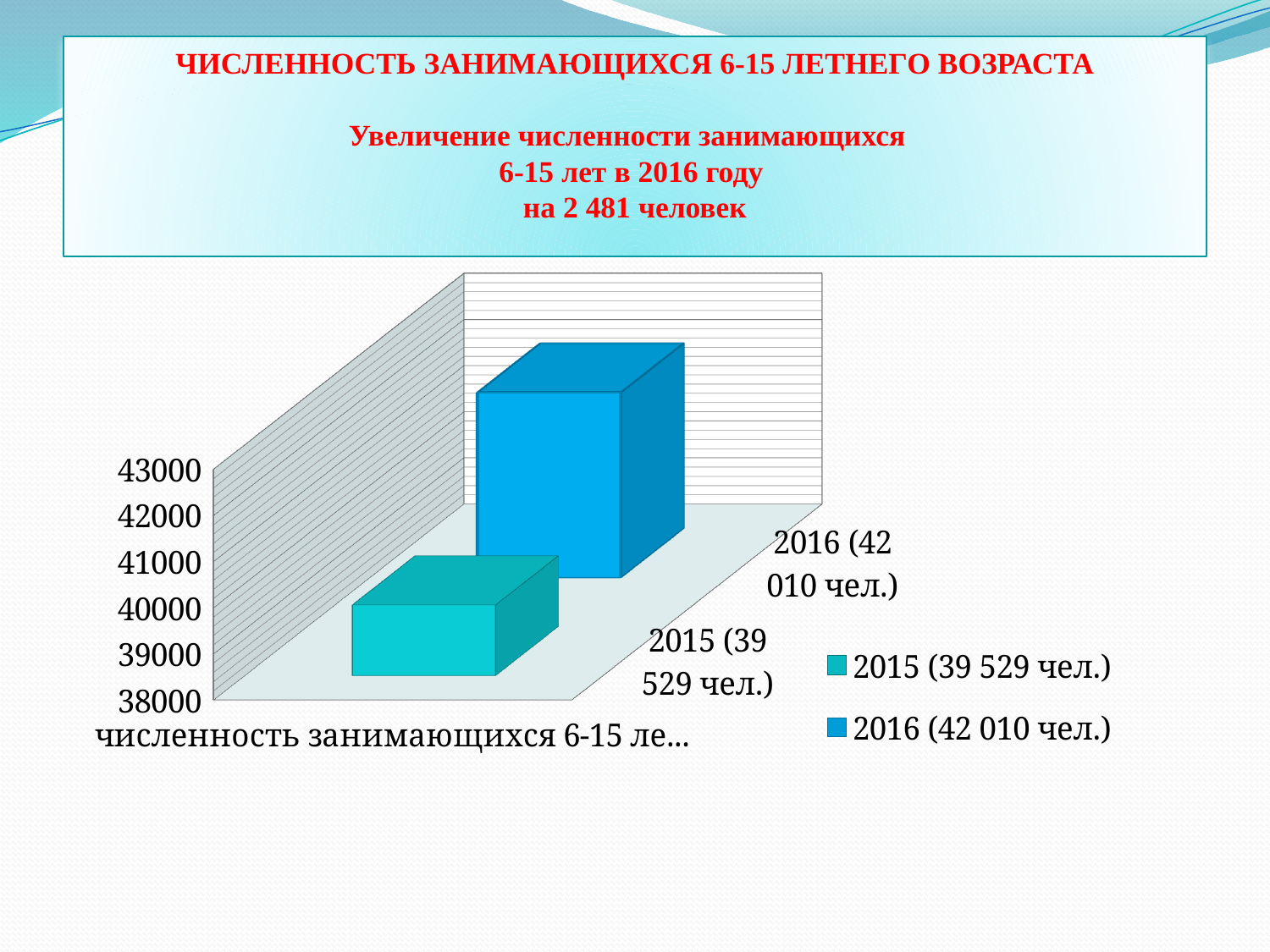
Which series has the lowest value? 2015 (39 529 чел.) Which series has the higher value, 2015 or 2016? 2016 Which series has the highest value? 2016 (42 010 чел.) How many series does the legend list? 2 Is the value for 2016 greater or less than 41000? greater What is the lowest value shown on the vertical axis? 38000 How many bars are plotted in the chart? 2 By how much does the 2016 value exceed the 2015 value? 2 481 What kind of chart is shown on the slide? bar chart What value is given for the 2015 series in the legend? 39 529 чел. What value is given for the 2016 series in the legend? 42 010 чел. Is the value for 2015 greater or less than 40000? less